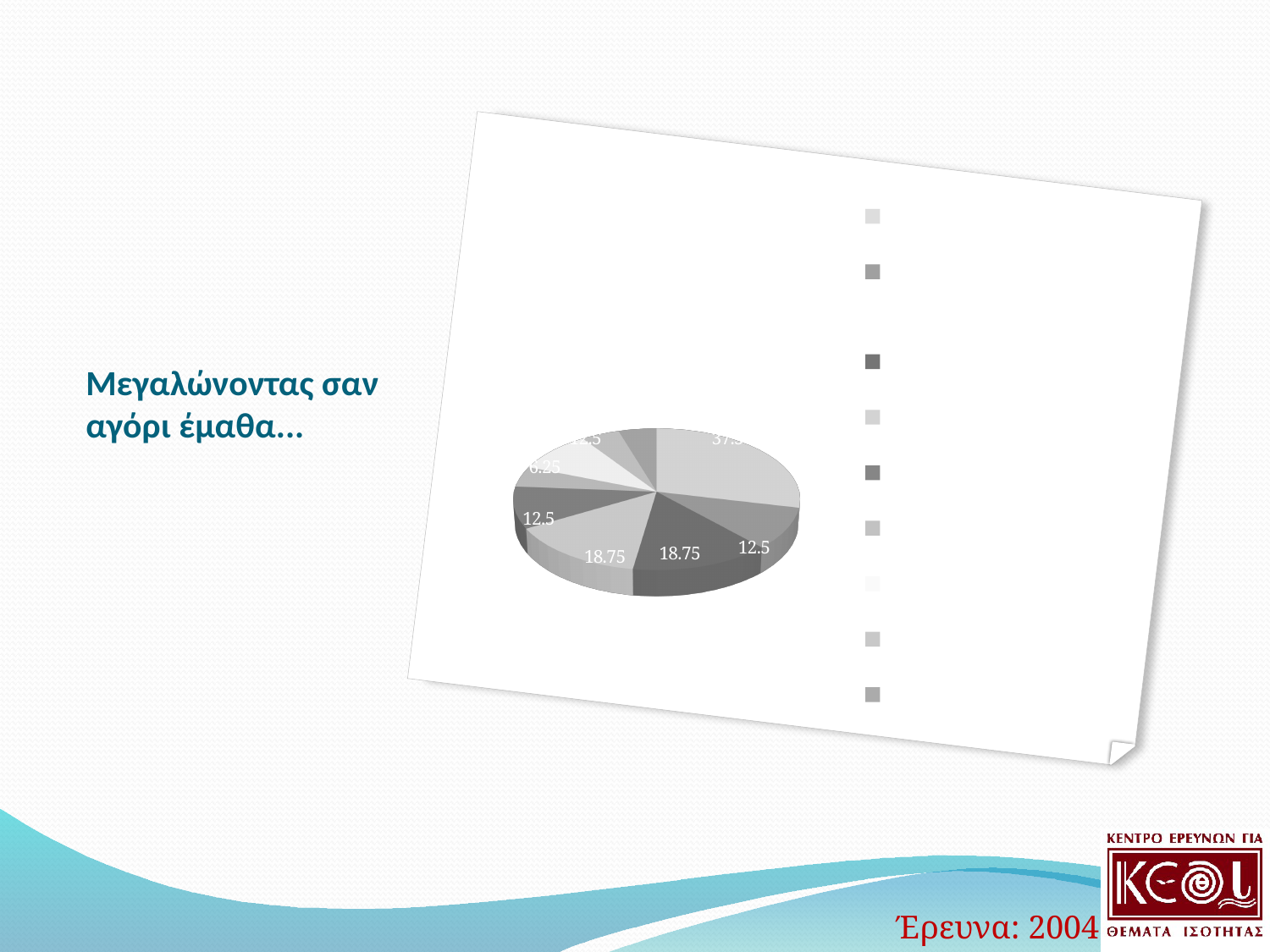
What kind of chart is shown on the slide? pie chart What is the difference between a slice labelled 18.75 and a slice labelled 12.5? 6.25 Which is larger, a slice labelled 18.75 or a slice labelled 6.25? 18.75 How many slices of the pie chart are labelled 18.75? 2 How many entries does the legend of the pie chart show? 9 What is the smallest value labelled on the pie chart? 6.25 What text appears to the left of the pie chart on the slide? Μεγαλώνοντας σαν αγόρι έμαθα...